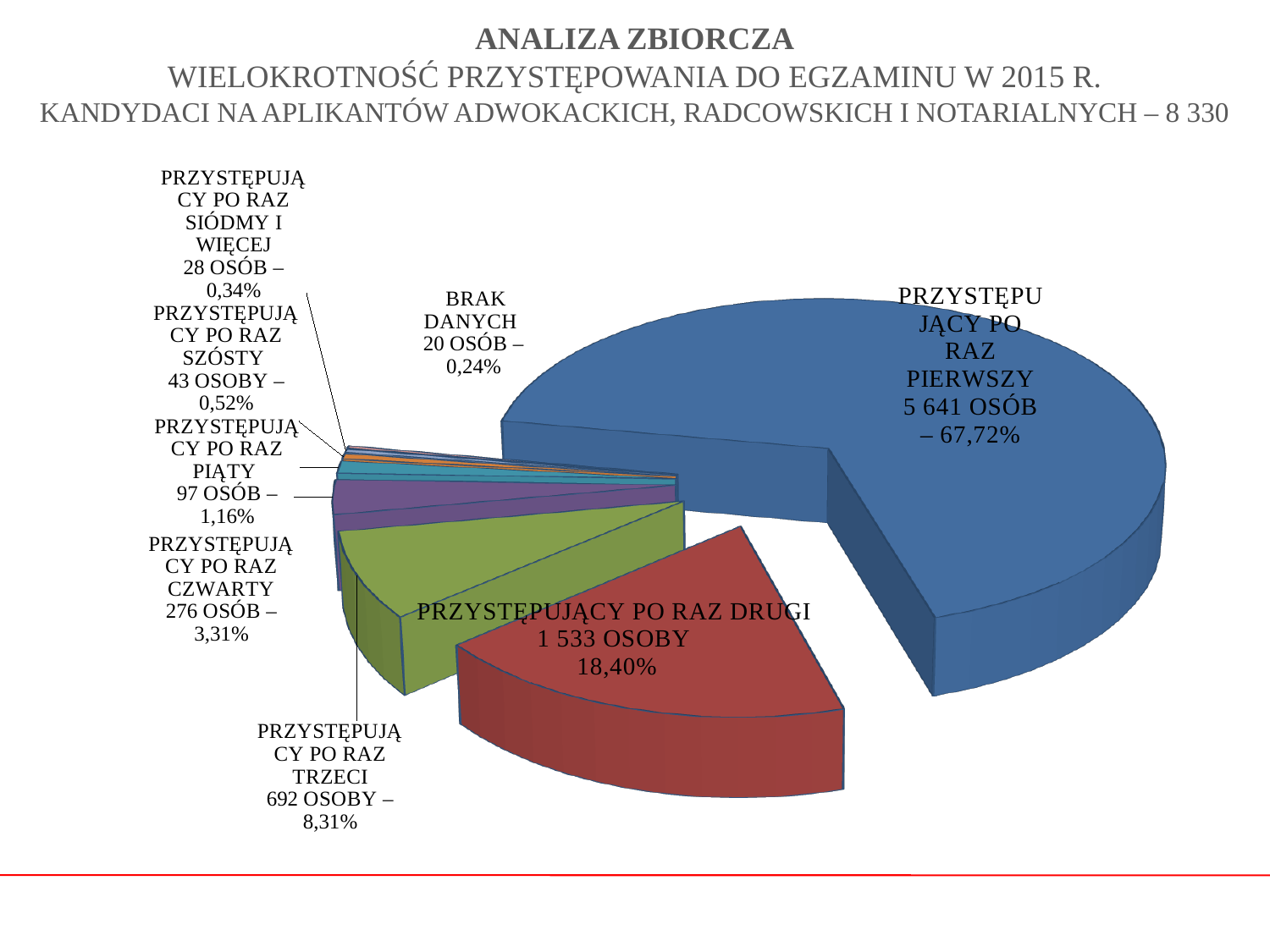
Which is larger: the number of people taking the exam for the fifth time or for the sixth time? fifth time (97) How many people are in the BRAK DANYCH (no data) category? 20 What percentage is shown for candidates taking the exam for the fourth time (PRZYSTĘPUJĄCY PO RAZ CZWARTY)? 3,31% What kind of chart is shown on the slide? pie chart Which category has the largest slice of the pie? PRZYSTĘPUJĄCY PO RAZ PIERWSZY How many people took the exam for the third time (PRZYSTĘPUJĄCY PO RAZ TRZECI)? 692 How many people took the exam for the first time (PRZYSTĘPUJĄCY PO RAZ PIERWSZY)? 5 641 What share of the pie is taken by candidates taking the exam for the second time (PRZYSTĘPUJĄCY PO RAZ DRUGI)? 18,40% What is the total number of candidates stated in the slide title? 8 330 Which category has the smallest slice of the pie? BRAK DANYCH How many categories (slices) does the pie chart have? 8 What is the difference in the number of people between those taking the exam for the first time and those taking it for the second time? 4 108